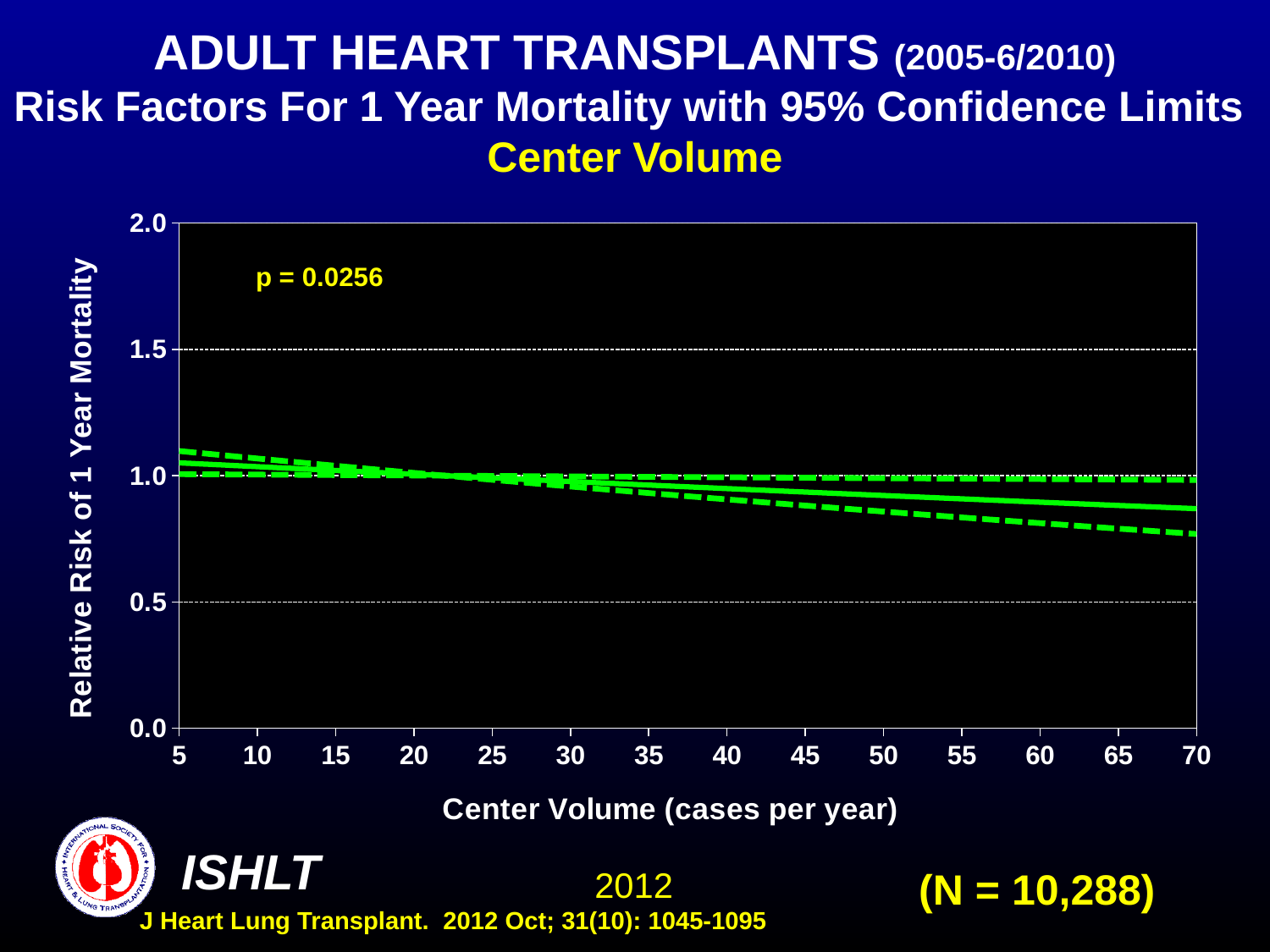
How many tick labels are shown on the x axis? 14 Is the relative risk of 1 year mortality at a center volume of 70 cases per year greater or less than 0.5? greater Does the relative risk of 1 year mortality rise or fall as center volume increases along the x axis? fall What is the label of the x axis? Center Volume (cases per year) Is the relative risk of 1 year mortality at a center volume of 70 cases per year greater or less than 1.0? less What is the sample size (N) shown on the slide? N = 10,288 How many lines are plotted on the chart? 3 What p-value is printed on the chart? p = 0.0256 What kind of chart is shown on the slide? line chart Is the lower 95% confidence limit at a center volume of 70 cases per year greater or less than 1.0? less What is the highest value shown on the y axis? 2.0